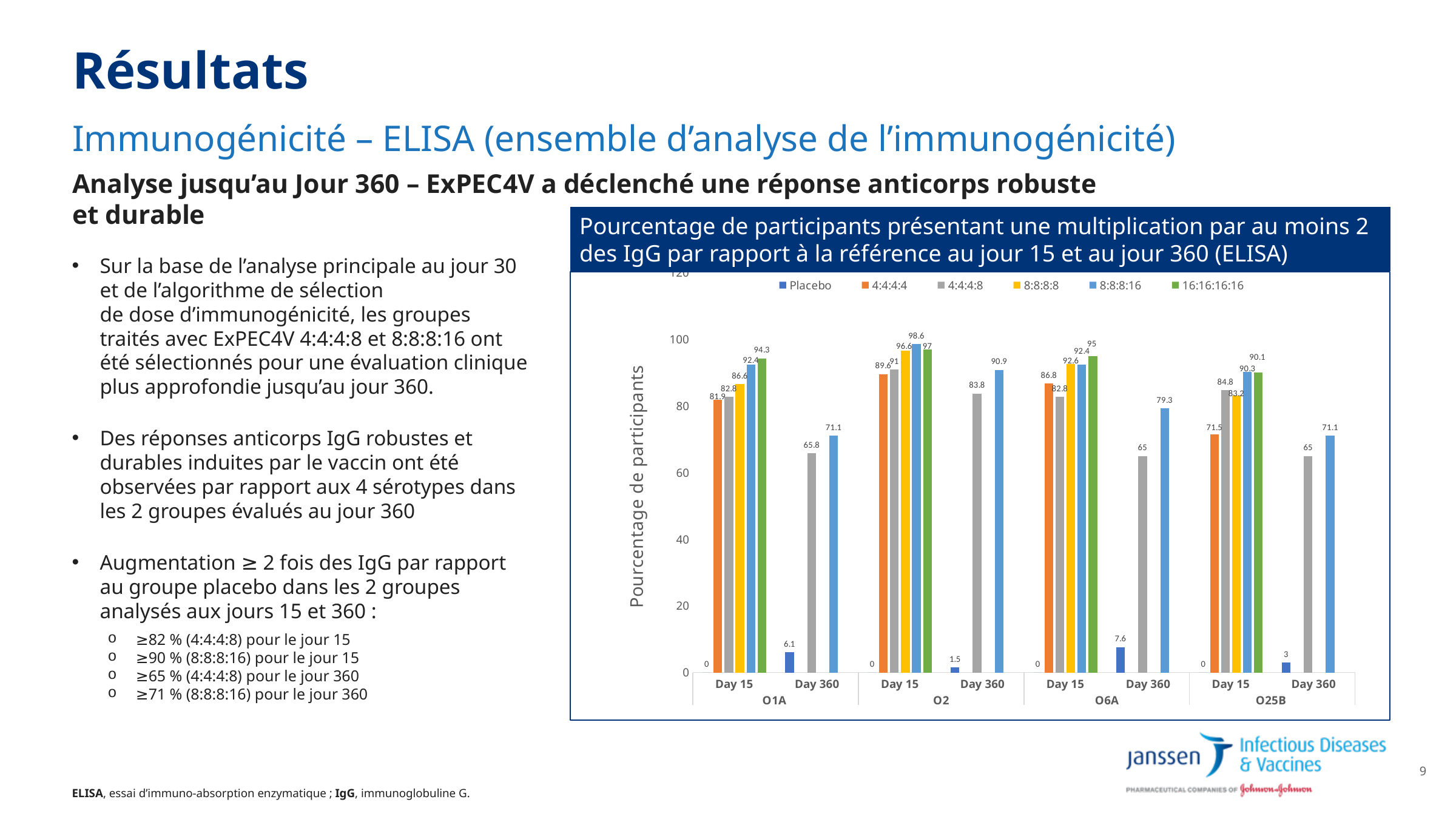
What is the value for the 4:4:4:8 group at Day 15 for serotype O2? 91 What is the value for the 8:8:8:16 group at Day 360 for serotype O1A? 71.1 Which group has the lowest non-placebo value at Day 15 for serotype O25B? 4:4:4:4 What is the Placebo value at Day 360 for serotype O6A? 7.6 What type of chart is shown on the slide? bar chart Is the value for the 4:4:4:8 group at Day 360 for serotype O2 greater or less than 80? greater What is the label of the vertical axis of the chart? Pourcentage de participants Which is larger at Day 15 for serotype O6A: the 4:4:4:4 group or the 4:4:4:8 group? 4:4:4:4 What is the value for the 16:16:16:16 group at Day 15 for serotype O25B? 90.1 How many series does the chart legend list? 6 What is the difference between the 8:8:8:16 and 4:4:4:8 values at Day 360 for serotype O6A? 14.3 Which group has the highest value at Day 15 for serotype O2? 8:8:8:16